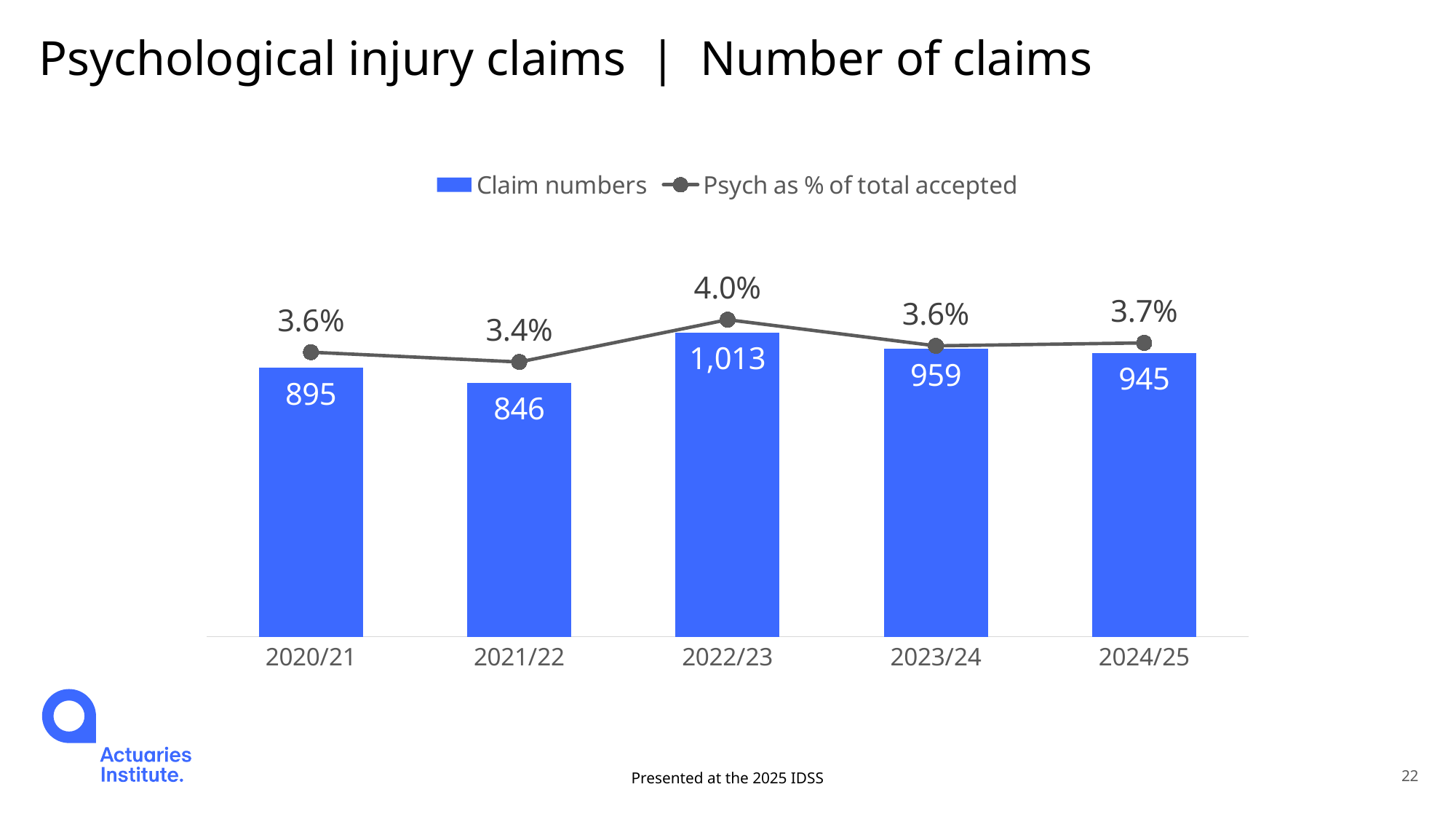
Which year has more claims, 2023/24 or 2024/25? 2023/24 What kind of chart is used for the Claim numbers series? Bar chart Do claim numbers rise or fall from 2022/23 to 2024/25? Fall What is the difference in claim numbers between 2022/23 and 2021/22? 167 What colour are the Claim numbers bars? Blue What is the number of claims for 2024/25? 945 Which year has the highest number of claims? 2022/23 How many years are shown on the x axis? 5 How many series does the legend list? 2 Which year has the lowest Psych as % of total accepted? 2021/22 What is the number of claims for 2022/23? 1,013 What is the Psych as % of total accepted value for 2021/22? 3.4%